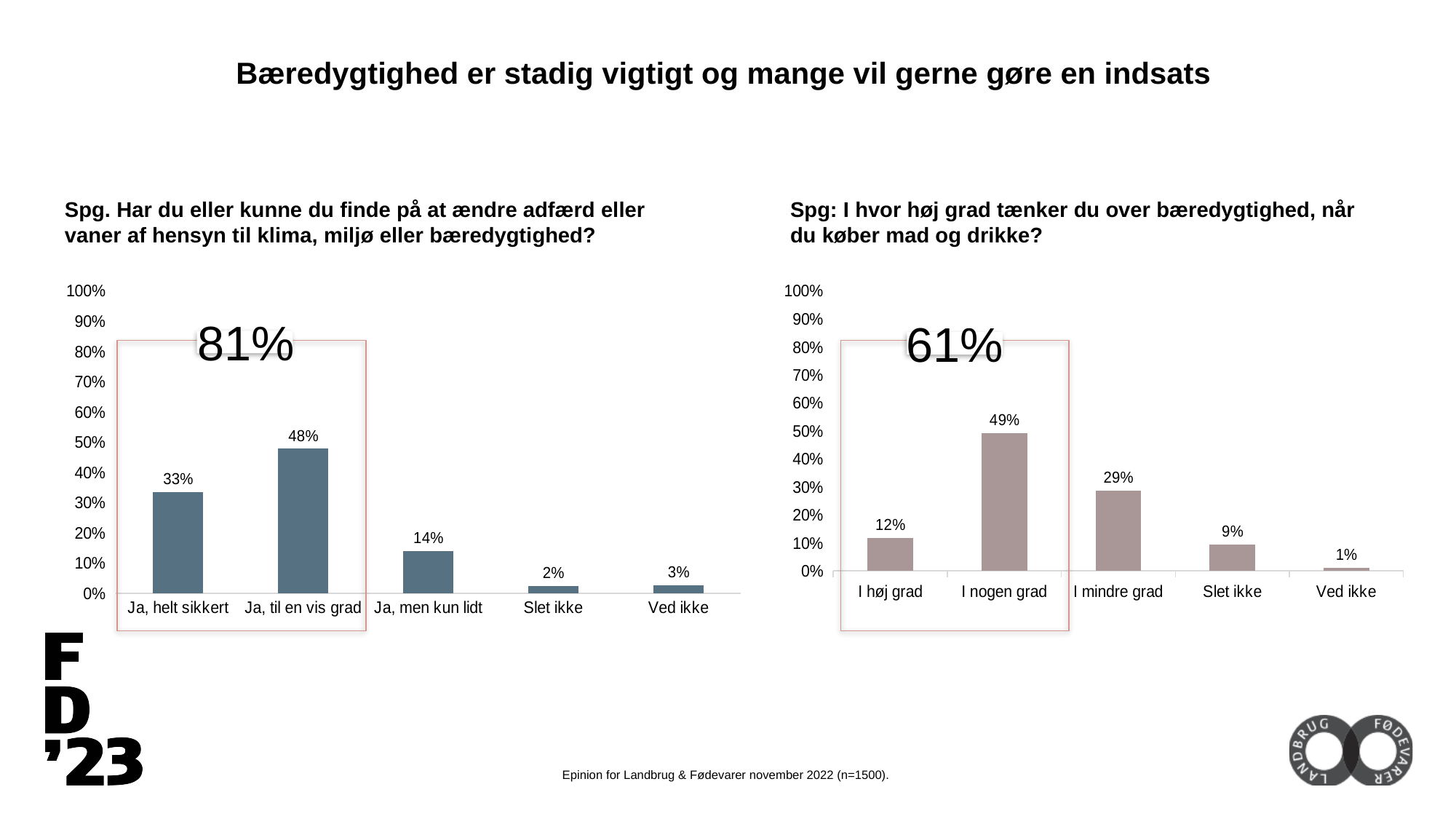
In the right chart, what is the difference between "I nogen grad" and "I mindre grad"? 20% In the left chart, which category has the highest value? Ja, til en vis grad How many categories does the left chart show? 5 In the left chart, what is the value for "Ja, men kun lidt"? 14% In the right chart, which category has the lowest value? Ved ikke What percentage is shown in the highlighted box on the right chart? 61% In the left chart, what is the value for "Ja, til en vis grad"? 48% In the left chart, what is the difference between "Ja, til en vis grad" and "Ja, helt sikkert"? 15% In the right chart, what is the value for "I mindre grad"? 29% In the right chart, what is the value for "Slet ikke"? 9% What kind of chart is the right chart? Bar chart In the right chart, which is larger: "I høj grad" or "Slet ikke"? I høj grad